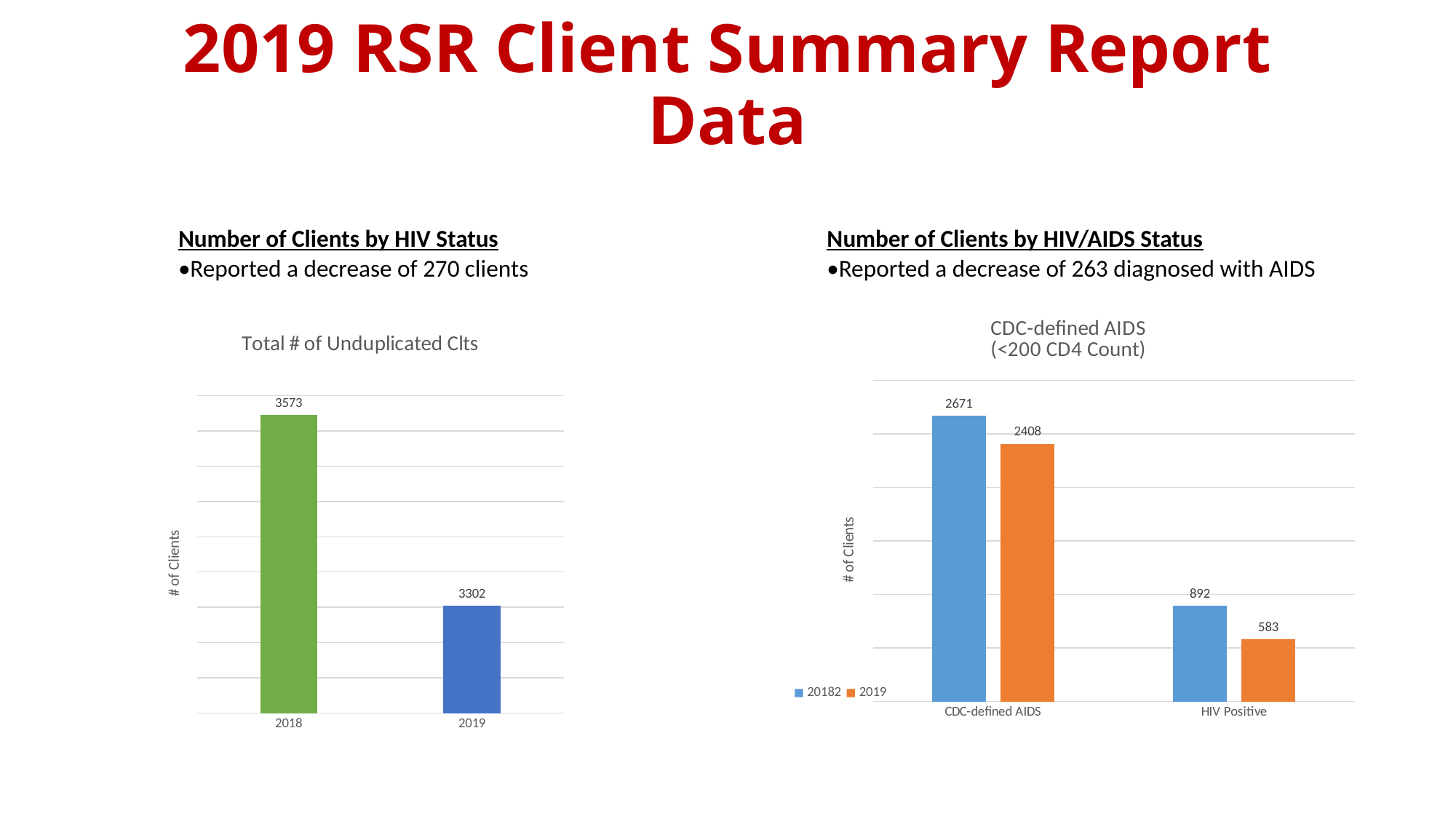
What kind of chart is the 'Total # of Unduplicated Clts' chart? Bar chart In the 'Total # of Unduplicated Clts' chart, how many bars are plotted? 2 How many series does the legend of the 'CDC-defined AIDS (<200 CD4 Count)' chart list? 2 In the 'Total # of Unduplicated Clts' chart, what is the difference between the 2018 and 2019 values? 271 In the 'Total # of Unduplicated Clts' chart, which year has the higher value? 2018 In the 'CDC-defined AIDS (<200 CD4 Count)' chart, what is the 2019 value for CDC-defined AIDS? 2408 In the 'CDC-defined AIDS (<200 CD4 Count)' chart, which bar is the lowest? HIV Positive, 2019 (583) What is the y-axis label of the 'CDC-defined AIDS (<200 CD4 Count)' chart? # of Clients In the 'CDC-defined AIDS (<200 CD4 Count)' chart, what is the 2019 value for HIV Positive? 583 In the 'CDC-defined AIDS (<200 CD4 Count)' chart, what is the difference between the two CDC-defined AIDS bars (2671 and 2408)? 263 In the 'Total # of Unduplicated Clts' chart, what is the value for 2018? 3573 In the 'Total # of Unduplicated Clts' chart, what is the value for 2019? 3302